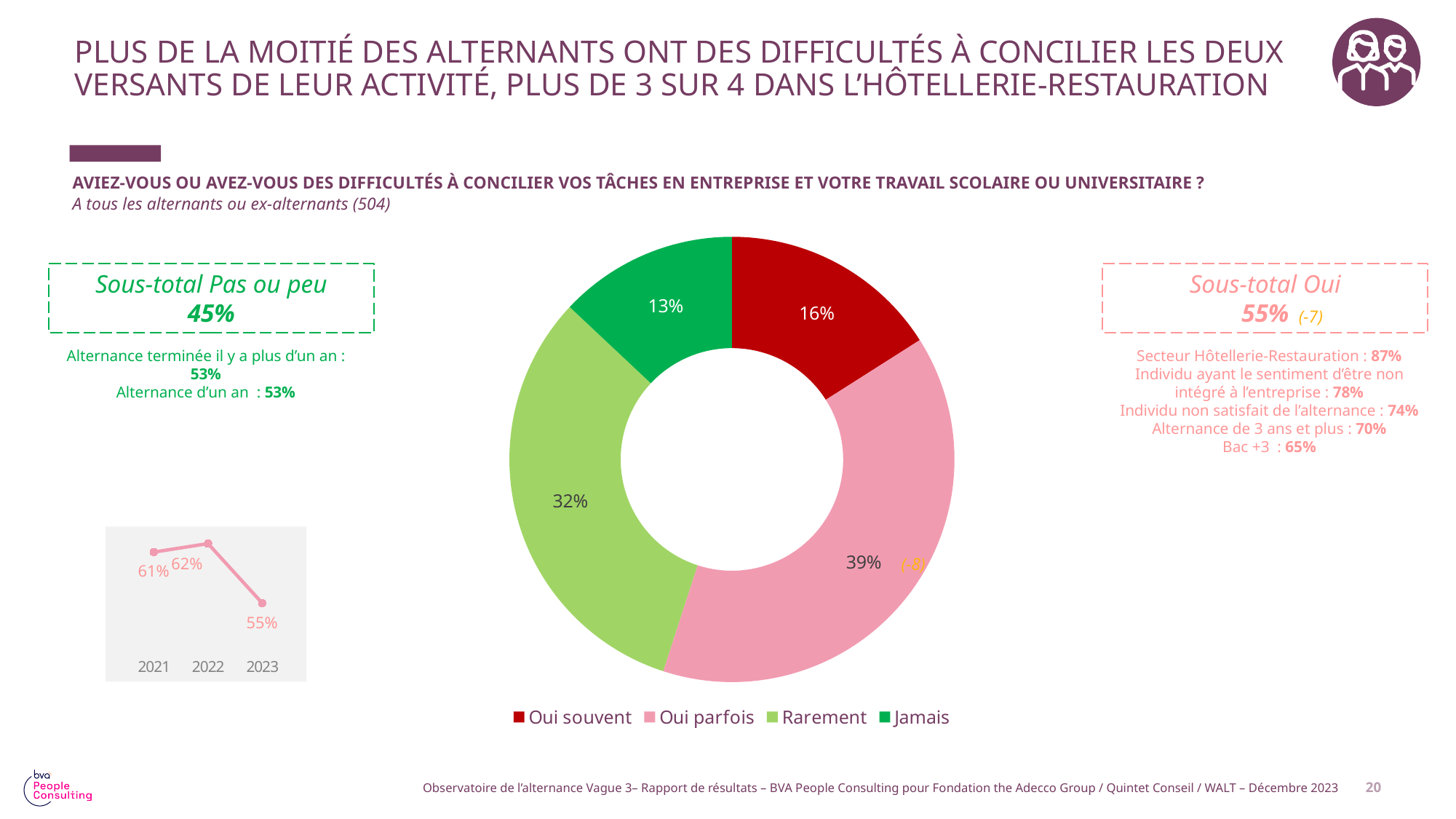
What kind of chart is the large chart in the centre of the slide? Donut (pie) chart How many categories does the legend of the donut chart list? 4 In the donut chart, what share is labelled for 'Oui parfois'? 39% In the small line chart at the bottom left, does the value rise or fall from 2022 to 2023? Fall In the donut chart, which is larger: 'Oui souvent' or 'Rarement'? Rarement In the donut chart, which category has the smallest slice? Jamais In the donut chart, what share is labelled for 'Oui souvent'? 16% In the donut chart, which category has the largest slice? Oui parfois In the donut chart, what is the difference between the 'Oui parfois' and 'Rarement' shares? 7 percentage points In the small line chart at the bottom left, how many years are plotted? 3 In the small line chart at the bottom left, what is the value for 2022? 62% In the donut chart, what share is labelled for 'Jamais'? 13%